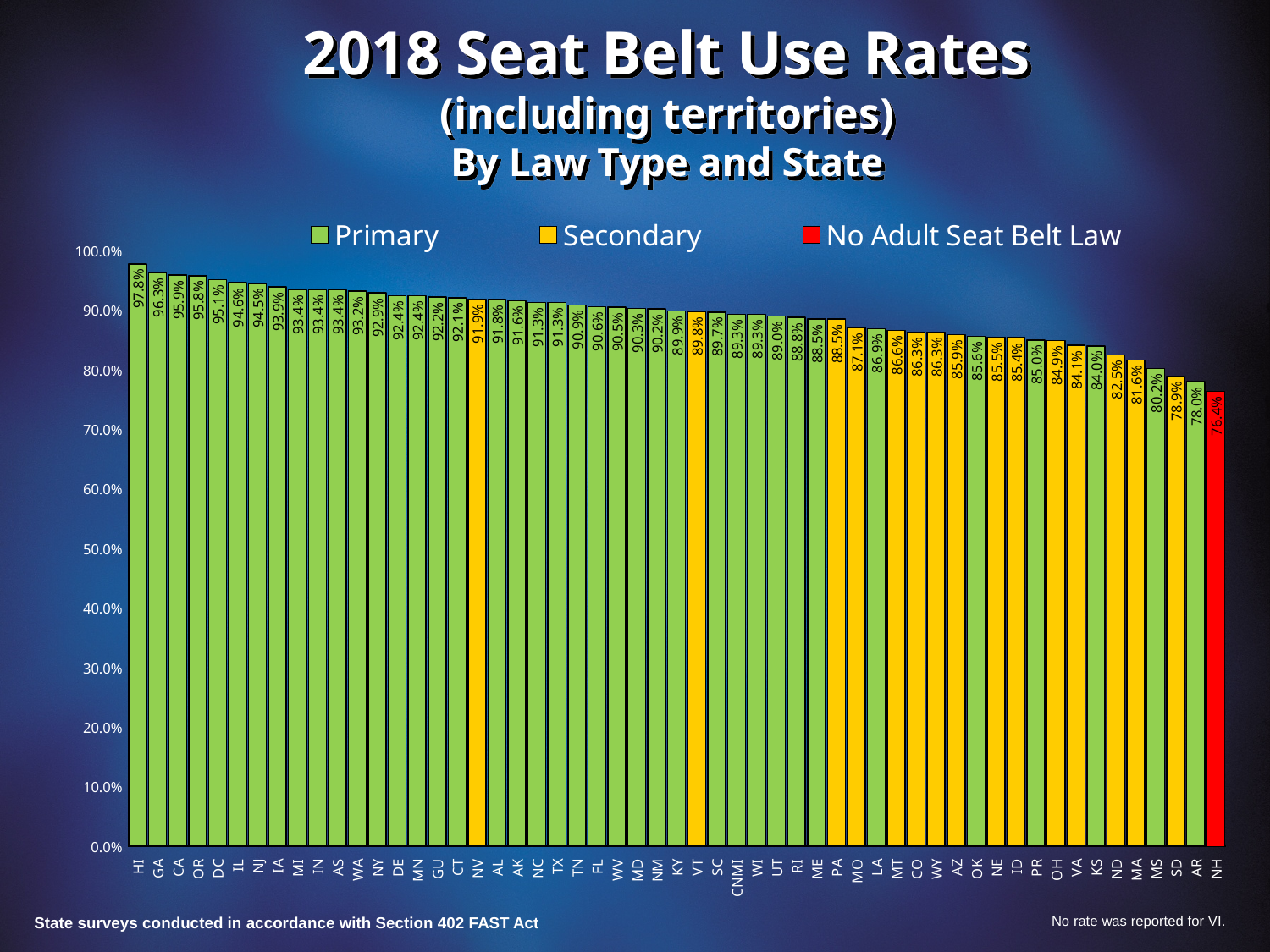
What kind of chart is shown on the slide? Bar chart Which state has the lowest seat belt use rate? NH What is the seat belt use rate for MO? 87.1% Which has a higher seat belt use rate, GA or AR? GA What is the seat belt use rate for TX? 91.3% How many series does the legend list? 3 Do the seat belt use rates rise or fall from left to right along the x axis? Fall What is the seat belt use rate for NH? 76.4% How many states and territories are shown on the x axis? 55 What is the seat belt use rate for HI? 97.8% What is the difference in seat belt use rate between HI and NH? 21.4 percentage points Which state has the highest seat belt use rate? HI